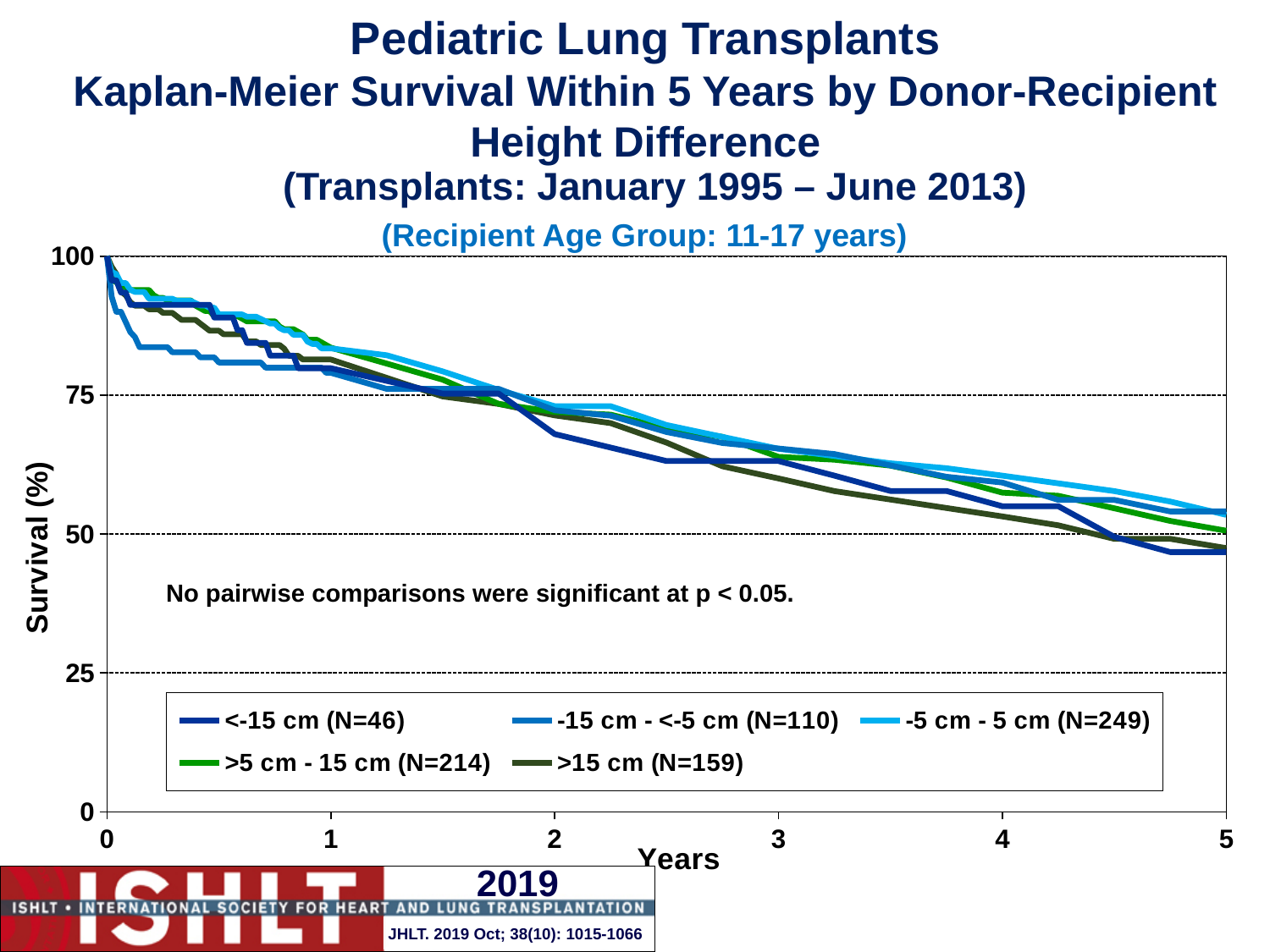
How many labelled tick marks are on the Years axis? 6 At 5 years, which has higher survival: the <-15 cm group or the -5 cm - 5 cm group? -5 cm - 5 cm What is the sample size (N) shown in the legend for the -5 cm - 5 cm group? 249 What is the label of the y axis? Survival (%) Is the survival value for the <-15 cm group at 2 years greater or less than 75? less Is the survival value for the >15 cm group at 3 years greater or less than 50? greater Do the survival curves rise or fall as years increase along the x axis? Fall Which group has the lowest survival at 5 years? <-15 cm (N=46) Is the survival value for the <-15 cm group at 5 years greater or less than 50? less What kind of chart is shown on the slide? Line chart How many series does the legend list? 5